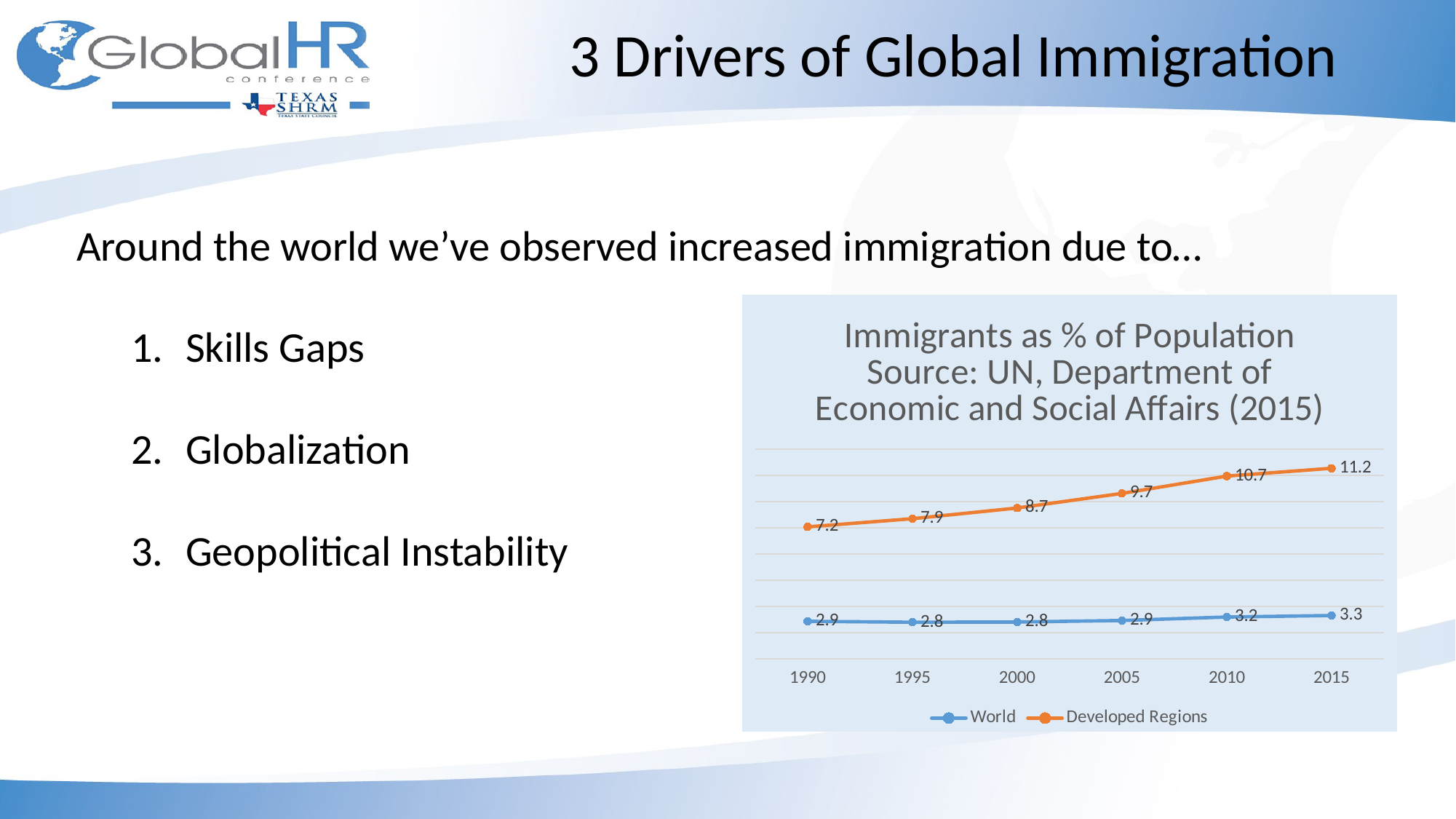
In which year is the Developed Regions value highest? 2015 Does the Developed Regions series rise or fall from 1990 to 2015? rise What is the value for Developed Regions in 2000? 8.7 In which year is the Developed Regions value lowest? 1990 How many series does the legend list? 2 What is the value for World in 1990? 2.9 How many years are shown on the x axis? 6 What type of chart is shown on the slide? line chart Which series has the larger value in 2005, World or Developed Regions? Developed Regions What is the value for World in 2010? 3.2 What is the difference between the Developed Regions and World values in 2015? 7.9 What is the value for Developed Regions in 2015? 11.2